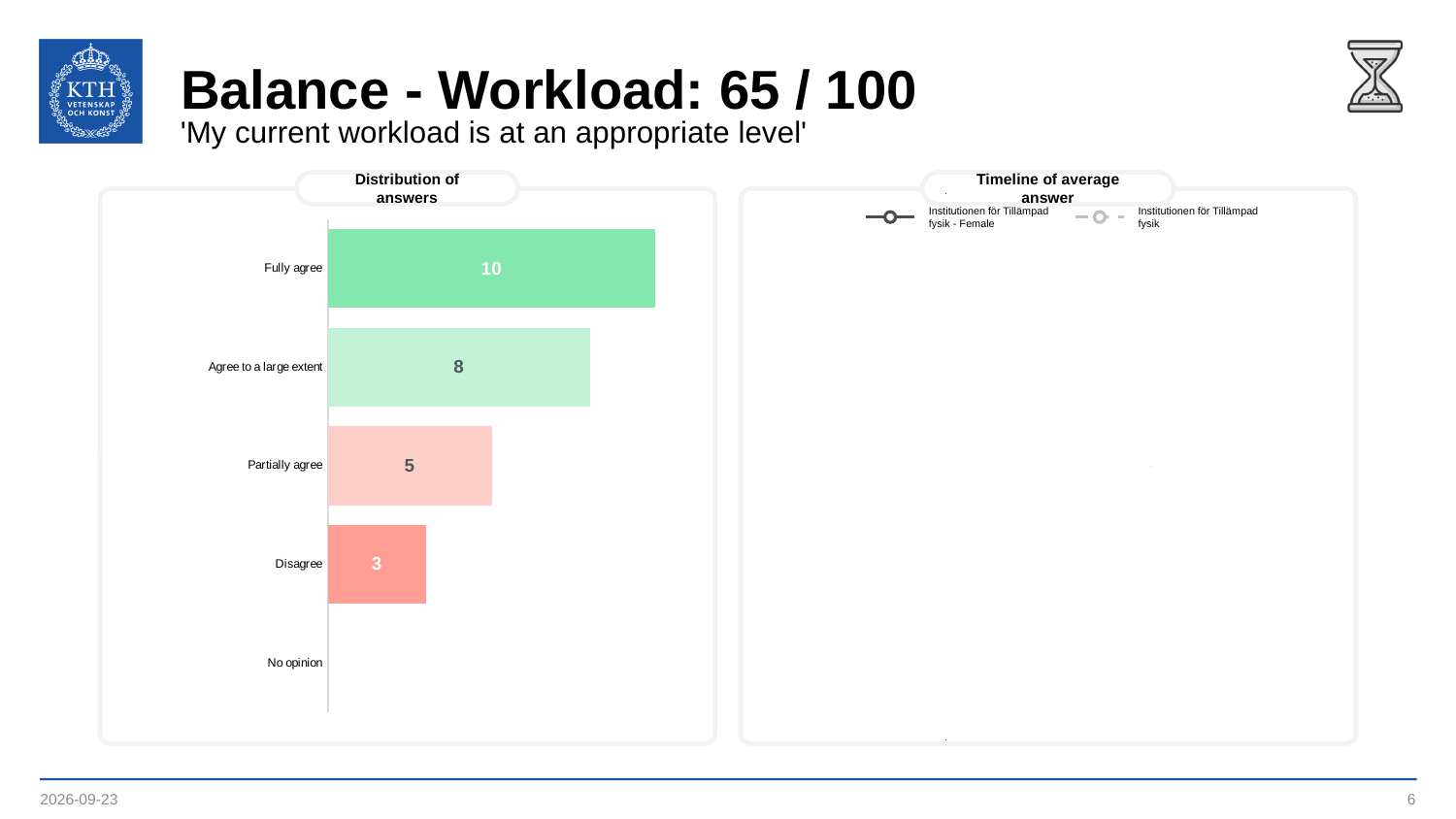
In the 'Distribution of answers' chart, what is the total of 'Fully agree', 'Agree to a large extent', 'Partially agree' and 'Disagree'? 26 How many series does the legend of the 'Timeline of average answer' chart list? 2 In the 'Distribution of answers' chart, how many respondents chose 'Fully agree'? 10 In the 'Distribution of answers' chart, how many answer categories are listed on the axis? 5 In the 'Distribution of answers' chart, what is the value for 'Agree to a large extent'? 8 In the 'Distribution of answers' chart, which is larger: 'Agree to a large extent' or 'Partially agree'? Agree to a large extent In the 'Distribution of answers' chart, which answer category has the highest value? Fully agree In the 'Distribution of answers' chart, which category with a visible bar has the lowest value? Disagree In the 'Distribution of answers' chart, what is the difference between 'Fully agree' and 'Disagree'? 7 In the 'Distribution of answers' chart, what is the value for 'Disagree'? 3 In the 'Distribution of answers' chart, what is the value for 'Partially agree'? 5 What kind of chart is the 'Distribution of answers' chart? Bar chart